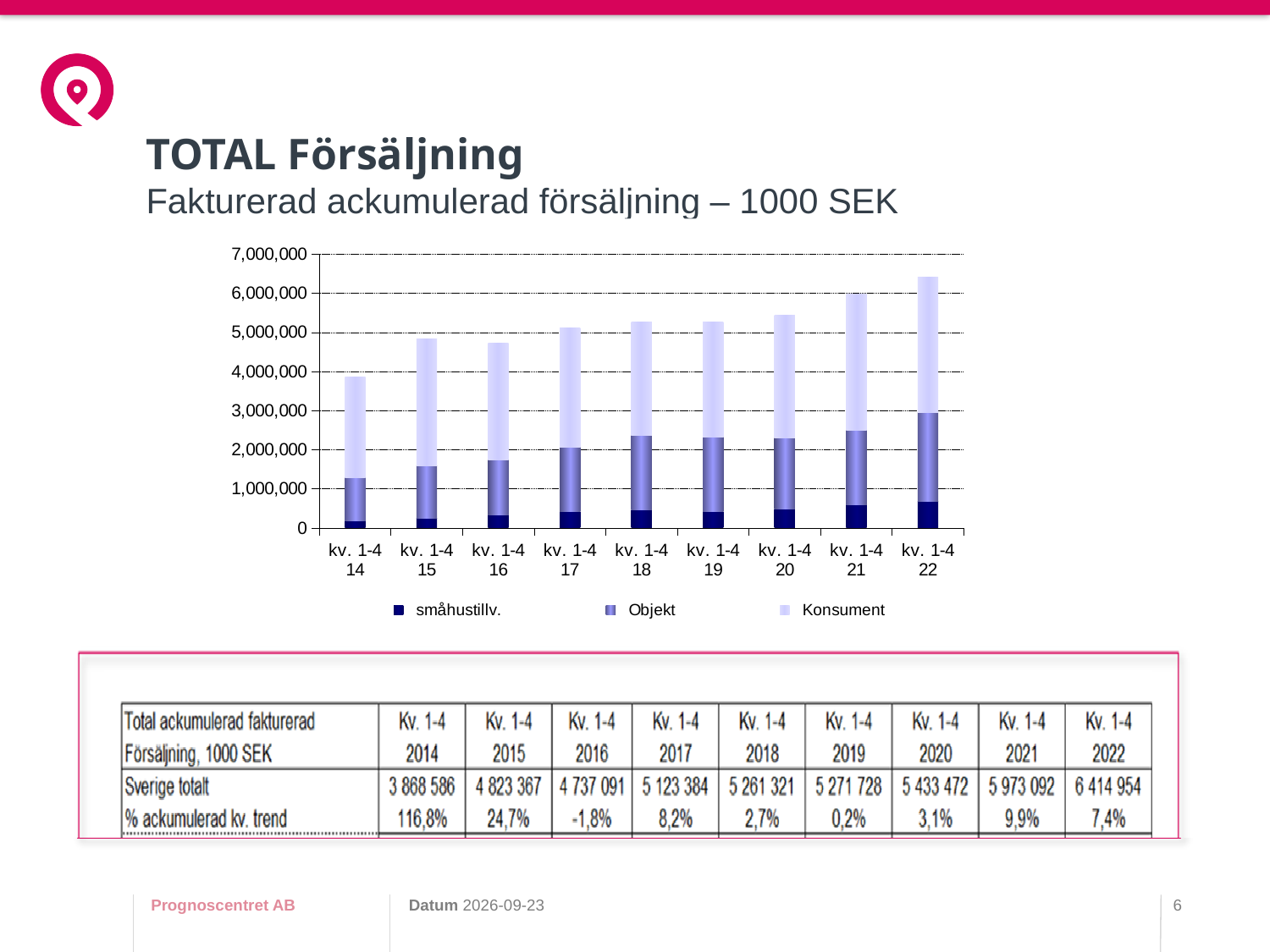
What are the three series named in the chart legend? småhustillv., Objekt, Konsument Which total is larger, kv. 1-4 14 or kv. 1-4 20? kv. 1-4 20 What kind of chart is shown on the slide? Stacked bar chart How many series does the chart legend list? 3 Which period has the lowest total stacked bar? kv. 1-4 14 Is the total for kv. 1-4 14 greater or less than 4,000,000? less Is the total for kv. 1-4 22 greater or less than 6,000,000? greater According to the table below the chart, what is the Sverige totalt value for Kv. 1-4 2022? 6 414 954 Do the total stacked bar values generally rise or fall from kv. 1-4 14 to kv. 1-4 22? rise How many periods (categories) are shown on the x axis of the chart? 9 Which period has the highest total stacked bar? kv. 1-4 22 Is the total for kv. 1-4 16 greater or less than 5,000,000? less